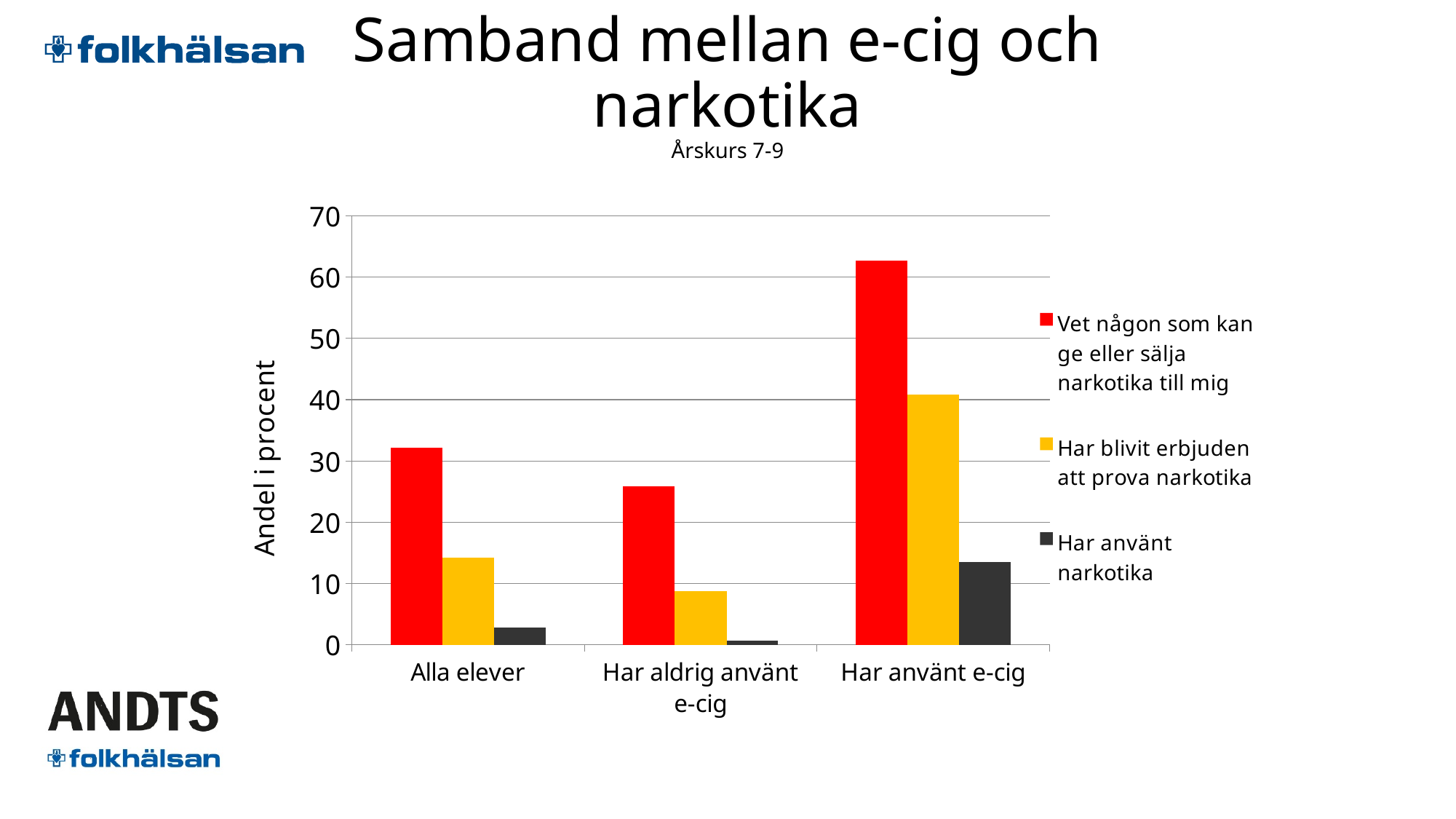
Which school grades does the chart's subtitle say the data covers? Årskurs 7-9 Is the value for 'Har blivit erbjuden att prova narkotika' in the 'Har använt e-cig' category greater or less than 50? less How many categories are shown on the x axis of the chart? 3 Which category has the highest value for 'Vet någon som kan ge eller sälja narkotika till mig'? Har använt e-cig How many series does the chart's legend list? 3 Which category has the lowest value for 'Har använt narkotika'? Har aldrig använt e-cig What kind of chart is shown on the slide? Bar chart Which is larger for 'Vet någon som kan ge eller sälja narkotika till mig': the value for 'Alla elever' or for 'Har aldrig använt e-cig'? Alla elever Is the value for 'Har blivit erbjuden att prova narkotika' in the 'Alla elever' category greater or less than 10? greater What is the label on the vertical axis of the chart? Andel i procent Is the value for 'Vet någon som kan ge eller sälja narkotika till mig' in the 'Har använt e-cig' category greater or less than 60? greater